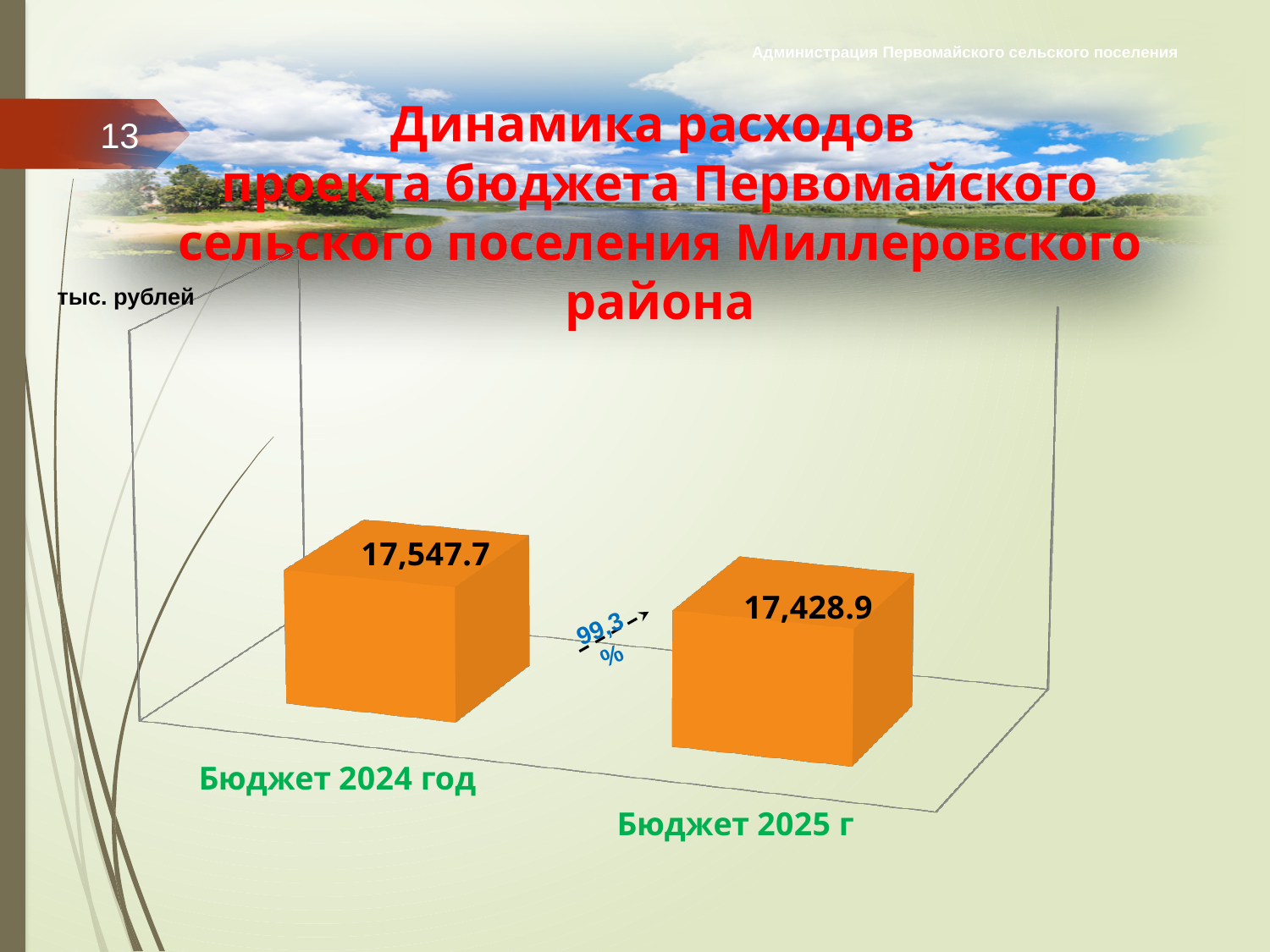
Which is larger, the value for Бюджет 2024 год or the value for Бюджет 2025 г? Бюджет 2024 год Which category has the highest value? Бюджет 2024 год What percentage is shown on the arrow between the two bars? 99.3 % Do the values rise or fall from Бюджет 2024 год to Бюджет 2025 г? Fall What is the difference between the values for Бюджет 2024 год and Бюджет 2025 г? 118.8 How many categories are plotted in the chart? 2 What unit of measurement is indicated for the chart values? тыс. рублей What is the value shown for Бюджет 2024 год? 17,547.7 What kind of chart is shown on the slide? Bar chart What is the value shown for Бюджет 2025 г? 17,428.9 Which category has the lowest value? Бюджет 2025 г